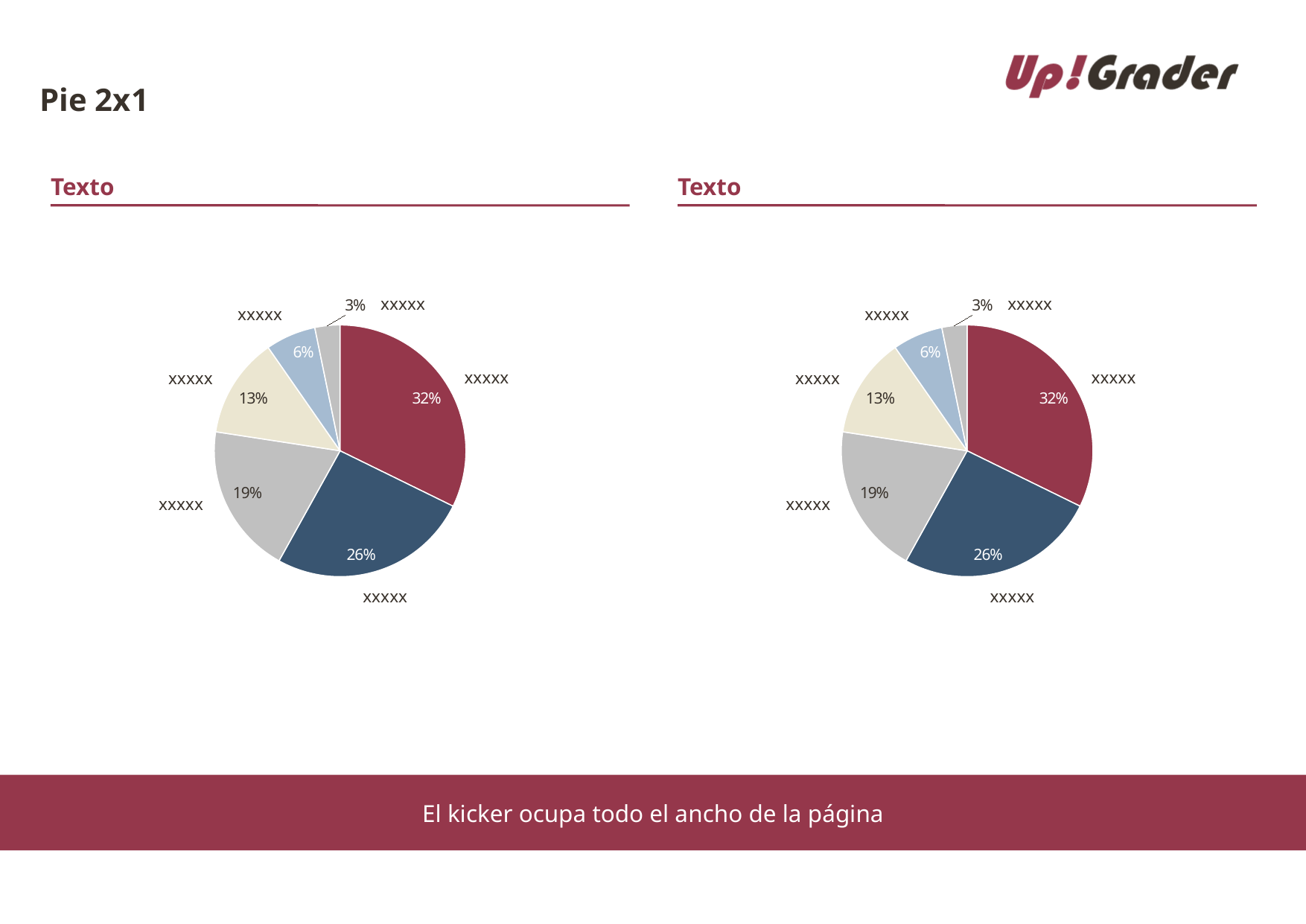
In the left pie chart, which is larger: the grey slice or the beige slice? The grey slice (19%) In the left pie chart, what is the combined share of the two largest slices (32% and 26%)? 58% In the left pie chart, what is the value of the largest slice? 32% How many slices does the left pie chart have? 6 In the left pie chart, what value is shown on the dark blue slice? 26% How many slices does the right pie chart have? 6 In the right pie chart, what is the value of the largest slice? 32% In the left pie chart, what is the value of the smallest slice? 3% What kind of chart is the left chart on the slide? Pie chart In the right pie chart, what value is shown on the light blue slice? 6% What colour is the largest slice in the left pie chart? Dark red In the left pie chart, what is the difference between the largest slice (32%) and the second-largest slice (26%)? 6 percentage points